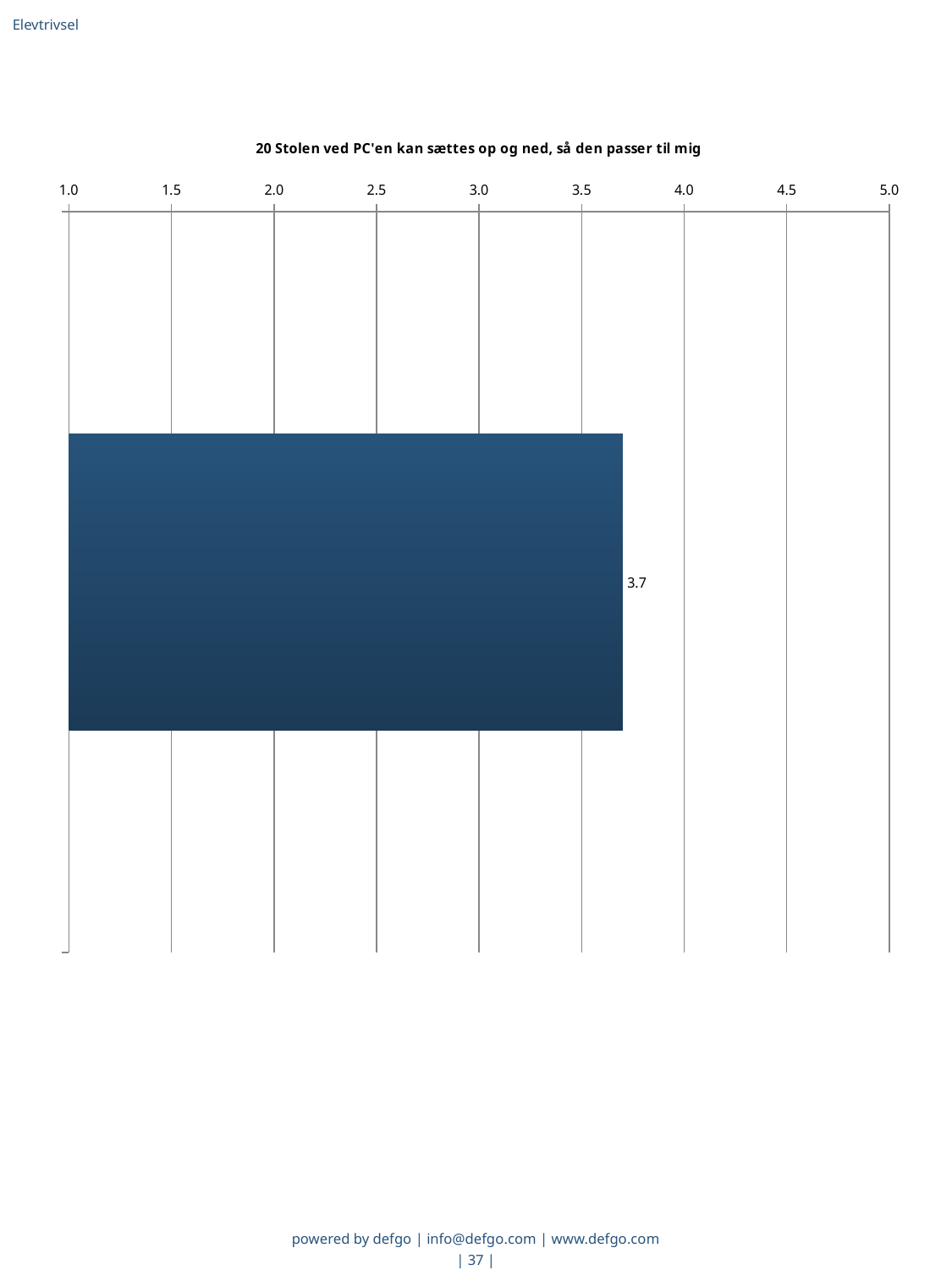
What kind of chart is shown on the slide? bar chart What is the highest value shown on the chart's horizontal axis? 5.0 Is the value of the bar greater or less than 3.5? greater Is the value of the bar greater or less than 4.0? less How many bars are plotted in the chart? 1 What is the title of the chart? 20 Stolen ved PC'en kan sættes op og ned, så den passer til mig What value is shown by the bar in the chart? 3.7 Is the value of the bar greater or less than 3.0? greater